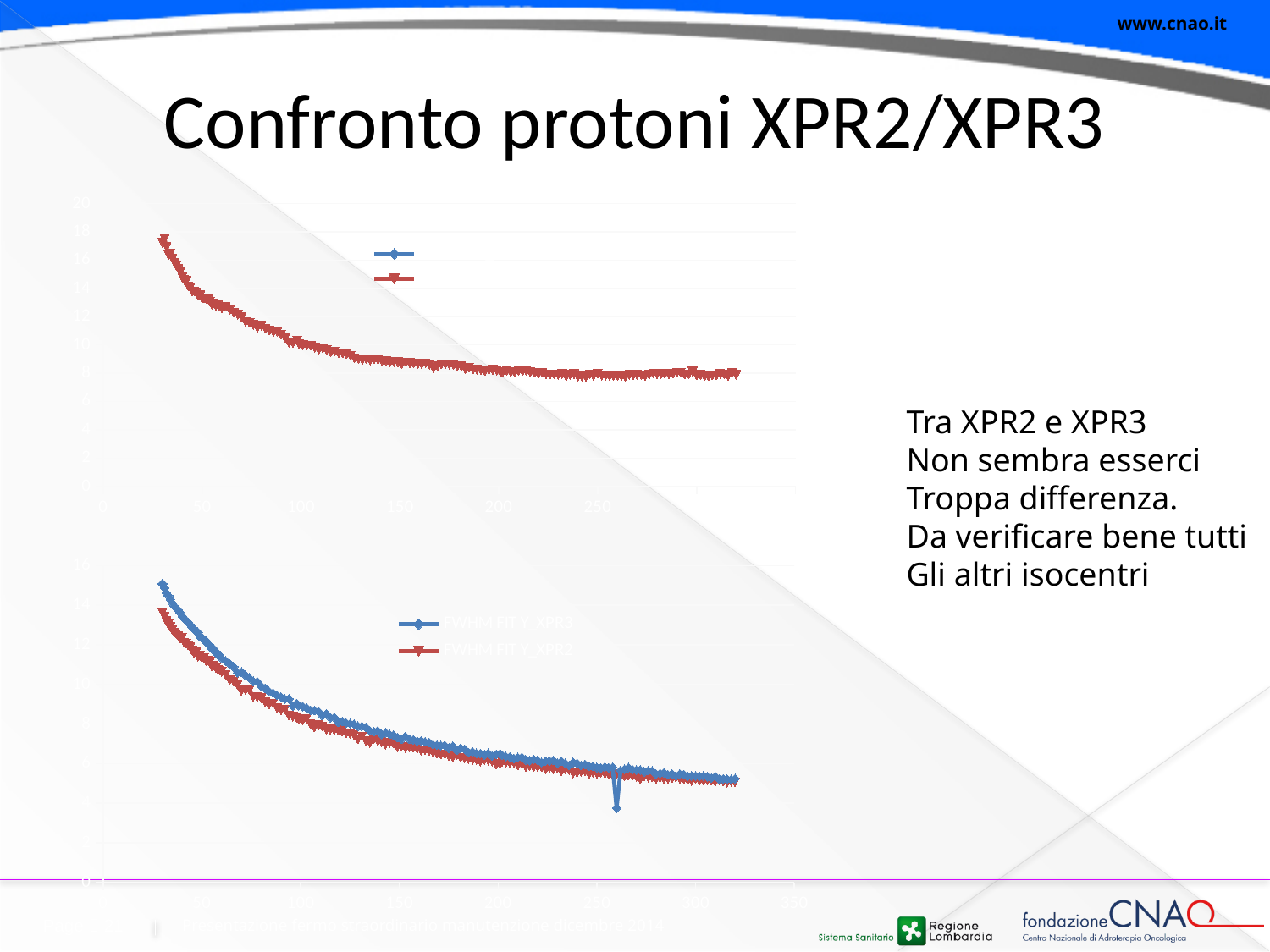
In the bottom chart, at x = 100, which series has the higher value, FWHM FIT Y_XPR3 or FWHM FIT Y_XPR2? FWHM FIT Y_XPR3 What is the title of the slide containing the two charts? Confronto protoni XPR2/XPR3 In the bottom chart, is the value of FWHM FIT Y_XPR3 at x = 50 greater or less than 10? greater In the bottom chart, which series is drawn in red? FWHM FIT Y_XPR2 In the bottom chart, do the values of FWHM FIT Y_XPR3 rise or fall as x increases? fall What kind of chart is the bottom chart on the slide? line chart In the top chart, is the value of the red series at x = 250 greater or less than 10? less In the top chart, is the value of the red series at x = 50 greater or less than 10? greater In the top chart, do the plotted values rise or fall as x increases? fall In the bottom chart, which series is drawn in blue? FWHM FIT Y_XPR3 How many series does the legend of the bottom chart list? 2